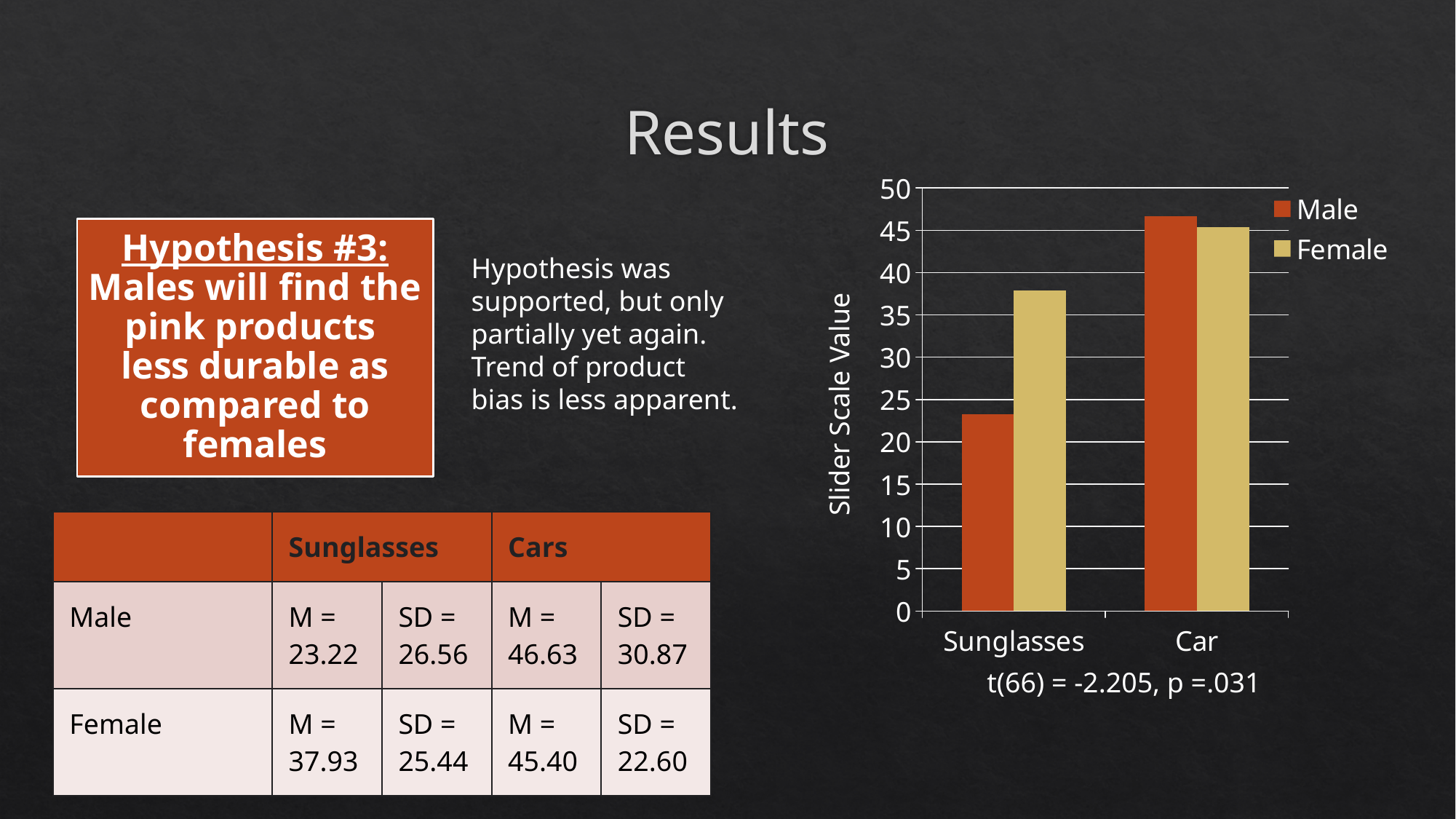
Which category has the highest Female value in the chart? Car What kind of chart is shown on the slide? bar chart Which category has the lowest Male value in the chart? Sunglasses Do the Male values rise or fall from Sunglasses to Car? rise Is the Male value for Sunglasses greater or less than 25? less Is the Male value for Car greater or less than 45? greater Is the Female value for Sunglasses greater or less than 35? greater How many categories are shown on the x axis of the chart? 2 Which series is shown in orange-red in the chart? Male For Sunglasses, which series has the larger value, Male or Female? Female How many series does the chart legend list? 2 What is the label of the chart's y axis? Slider Scale Value